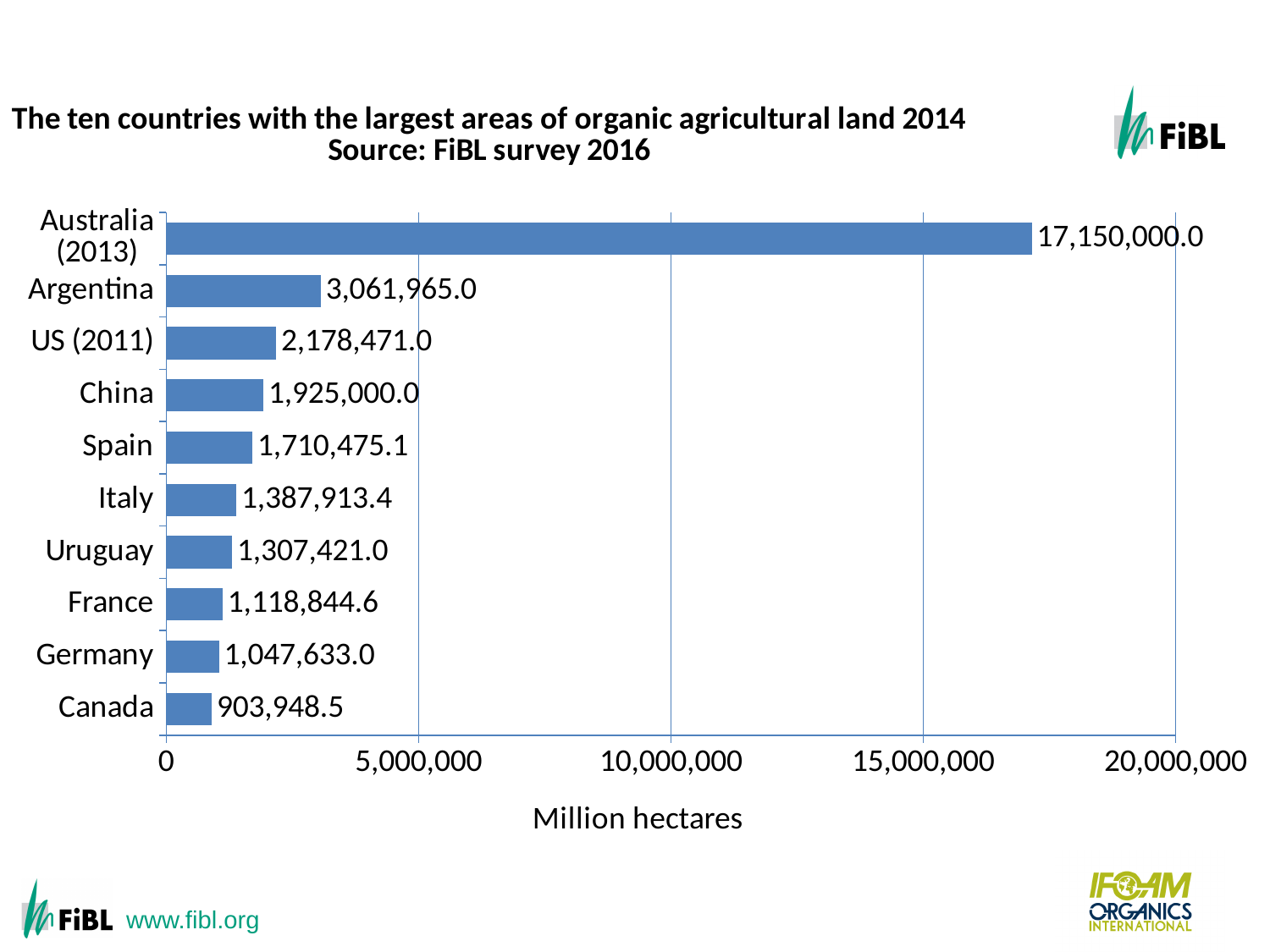
What is the value for Spain? 1,710,475.1 Which country has the smallest value on the chart? Canada What is the source given in the chart title? FiBL survey 2016 What is the value for Canada? 903,948.5 Which is larger, the value for China or the value for Italy? China What kind of chart is shown on the slide? bar chart How many countries are shown on the chart? 10 Is the value for Australia (2013) greater or less than 15,000,000? greater What is the label of the horizontal axis? Million hectares What is the value for Argentina? 3,061,965.0 Which country has the largest area of organic agricultural land? Australia (2013) What is the difference between the values for Argentina and US (2011)? 883,494.0